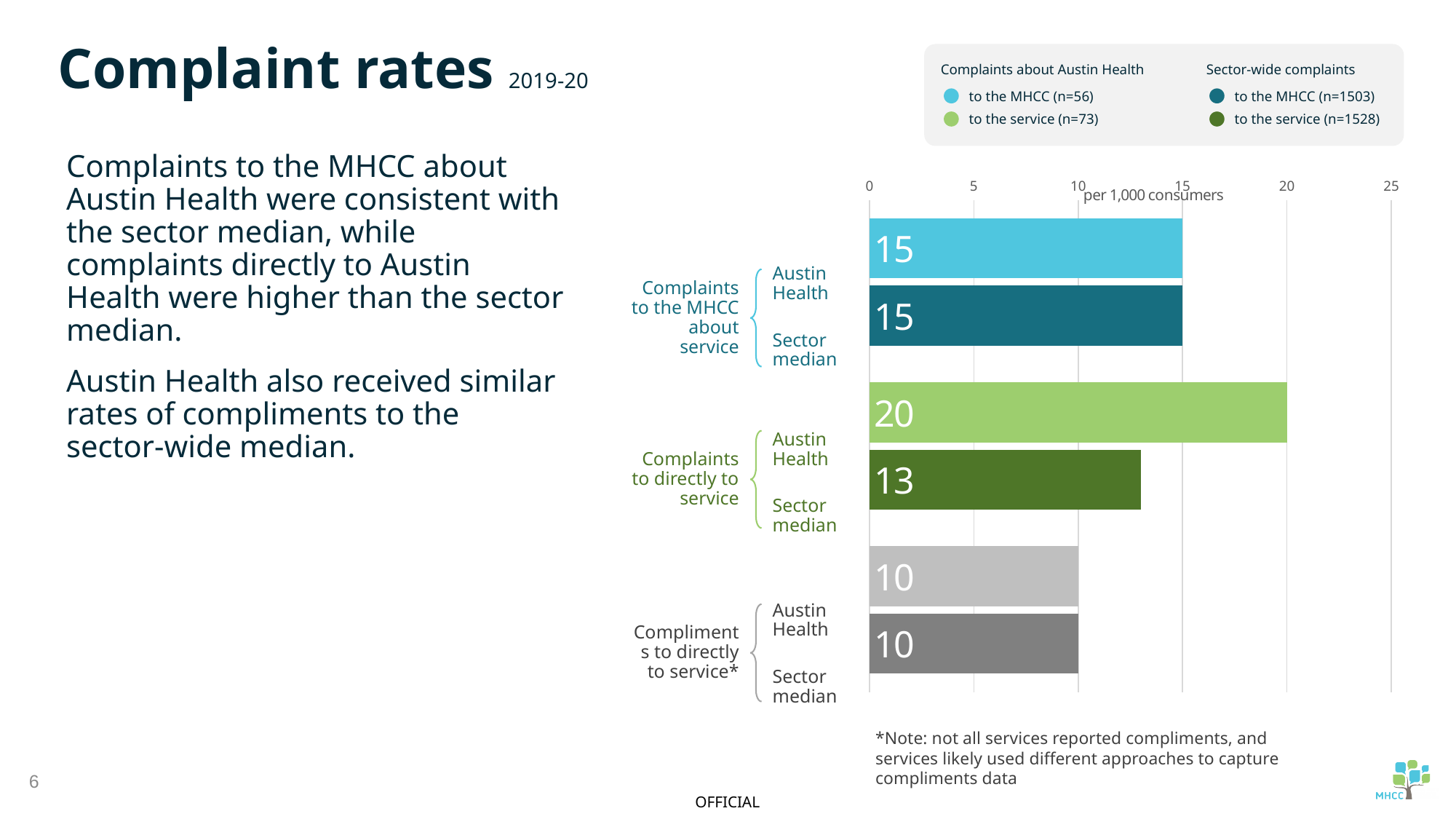
According to the legend, how many complaints about Austin Health were made to the service (n)? 73 How many bars are plotted on the chart? 6 What is the value for Austin Health complaints to the MHCC about service? 15 Which bar has the highest value on the chart? Austin Health complaints directly to service Which is larger for complaints directly to service: Austin Health or the sector median? Austin Health What is the value for Austin Health complaints directly to service? 20 What is the sector median for complaints directly to service? 13 What kind of chart is shown on the slide? Bar chart What unit is shown on the chart's axis? per 1,000 consumers What is the value for Austin Health compliments directly to service? 10 What is the difference between Austin Health and the sector median for complaints directly to service? 7 What is the sector median for complaints to the MHCC about service? 15